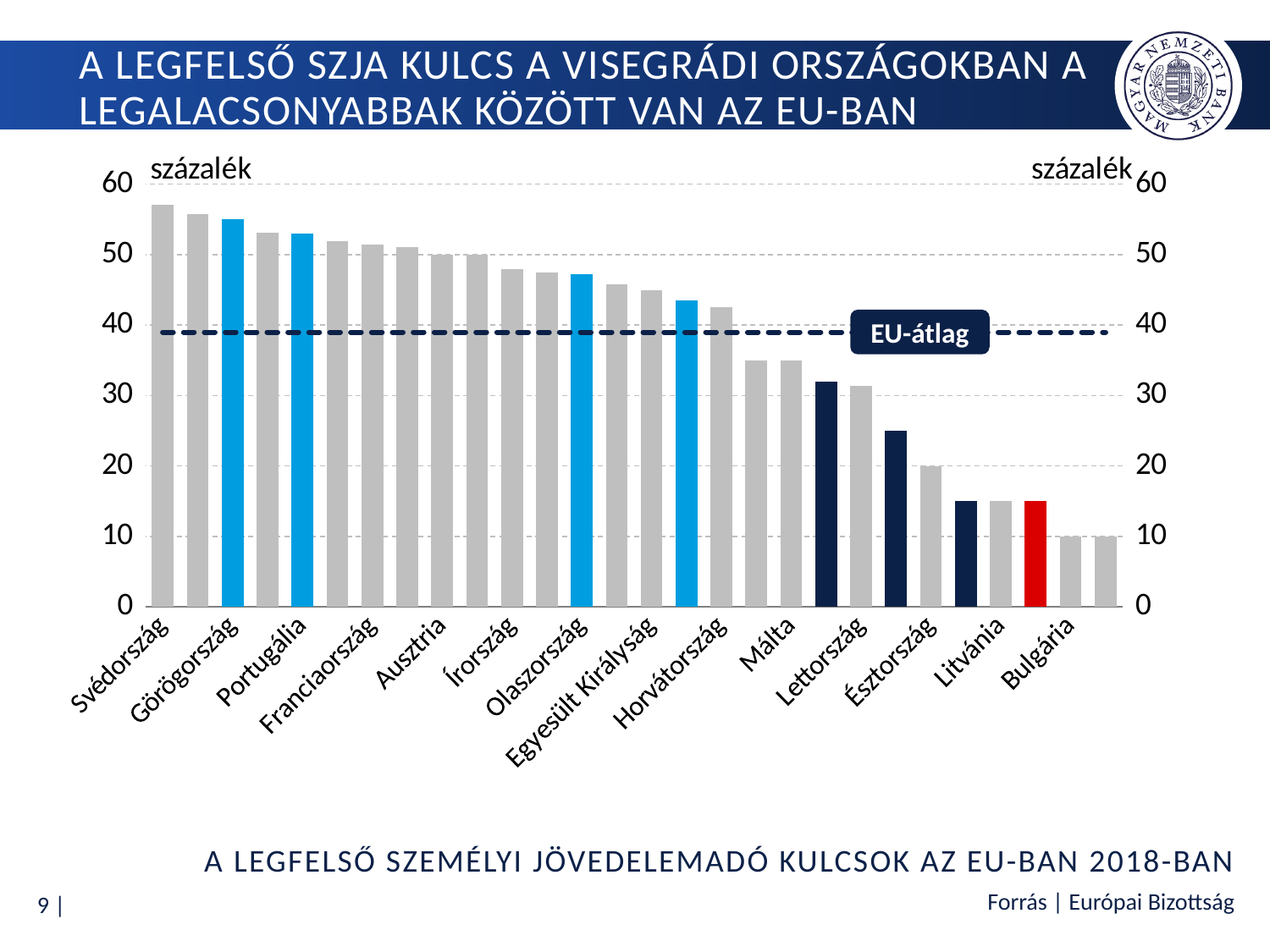
Is the value for Svédország greater or less than 50? greater What type of chart is shown on the slide? bar chart Is the value for Litvánia greater or less than 20? less Which country has the highest top personal income tax rate in the chart? Svédország Is the value for Lettország greater or less than 40? less Which is higher, the value for Svédország or the value for Málta? Svédország What unit is shown on the y axis of the chart? százalék Do the bar values rise or fall from left to right along the x axis? fall What does the dashed horizontal line across the chart represent, according to its label? EU-átlag Which is higher, the value for Görögország or the value for Olaszország? Görögország